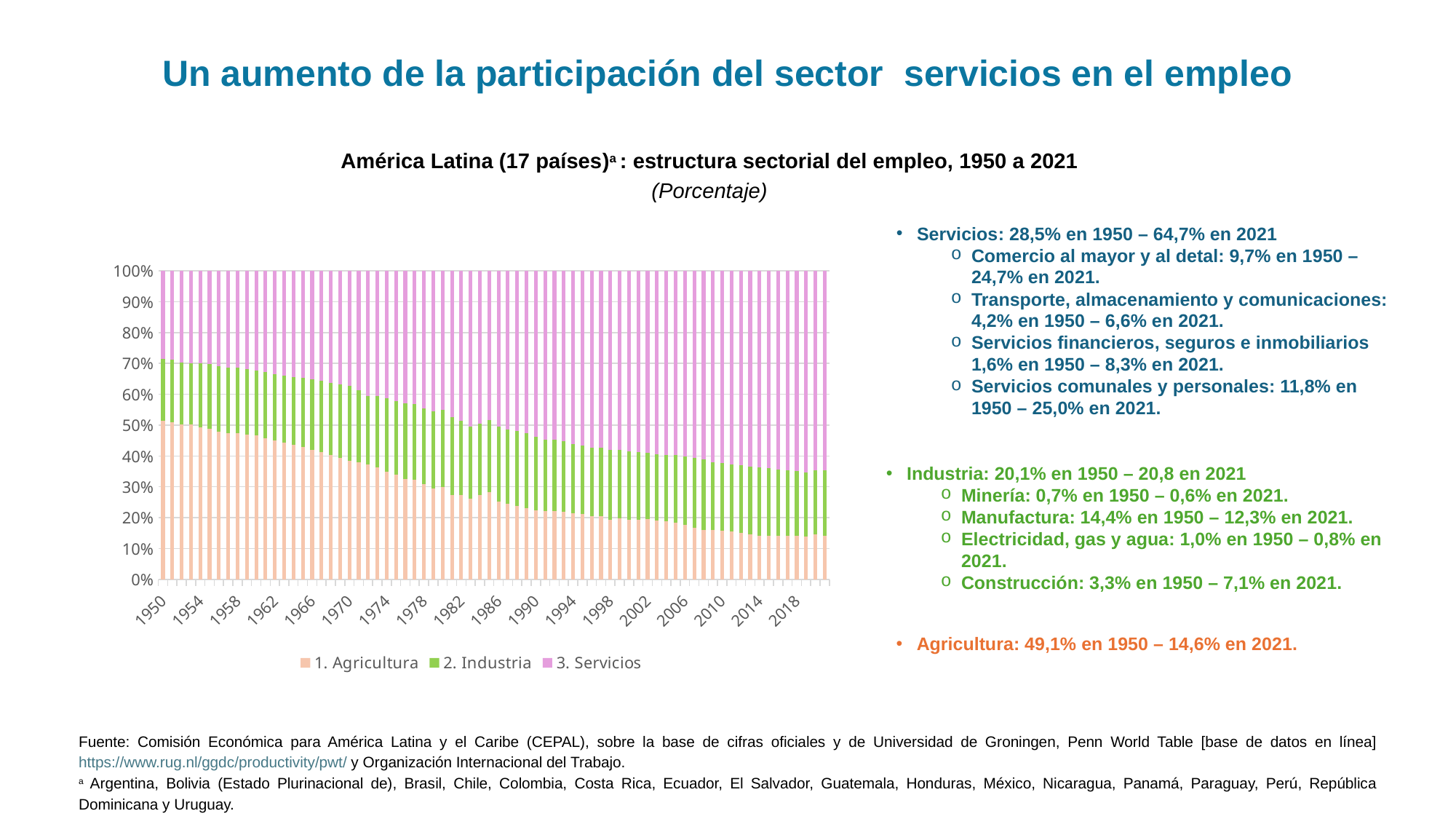
What is the total of each stacked bar in the chart? 100% According to the slide, what was the Servicios share of employment in 1950? 28,5% Does the share of Servicios rise or fall from 1950 to 2021 along the x axis? Rise In 2018, which is larger: the Servicios share or the Agricultura share? Servicios How many series does the chart legend list? 3 Is the Agricultura share in 2018 greater or less than 20%? less Is the Servicios share in 1950 greater or less than 40%? less What kind of chart is shown on the slide? Stacked bar chart According to the slide, what was the Agricultura share of employment in 2021? 14,6% What are the three series listed in the chart legend? 1. Agricultura, 2. Industria, 3. Servicios Does the share of Agricultura rise or fall from 1950 to 2021 along the x axis? Fall Is the Agricultura share in 1950 greater or less than 40%? greater